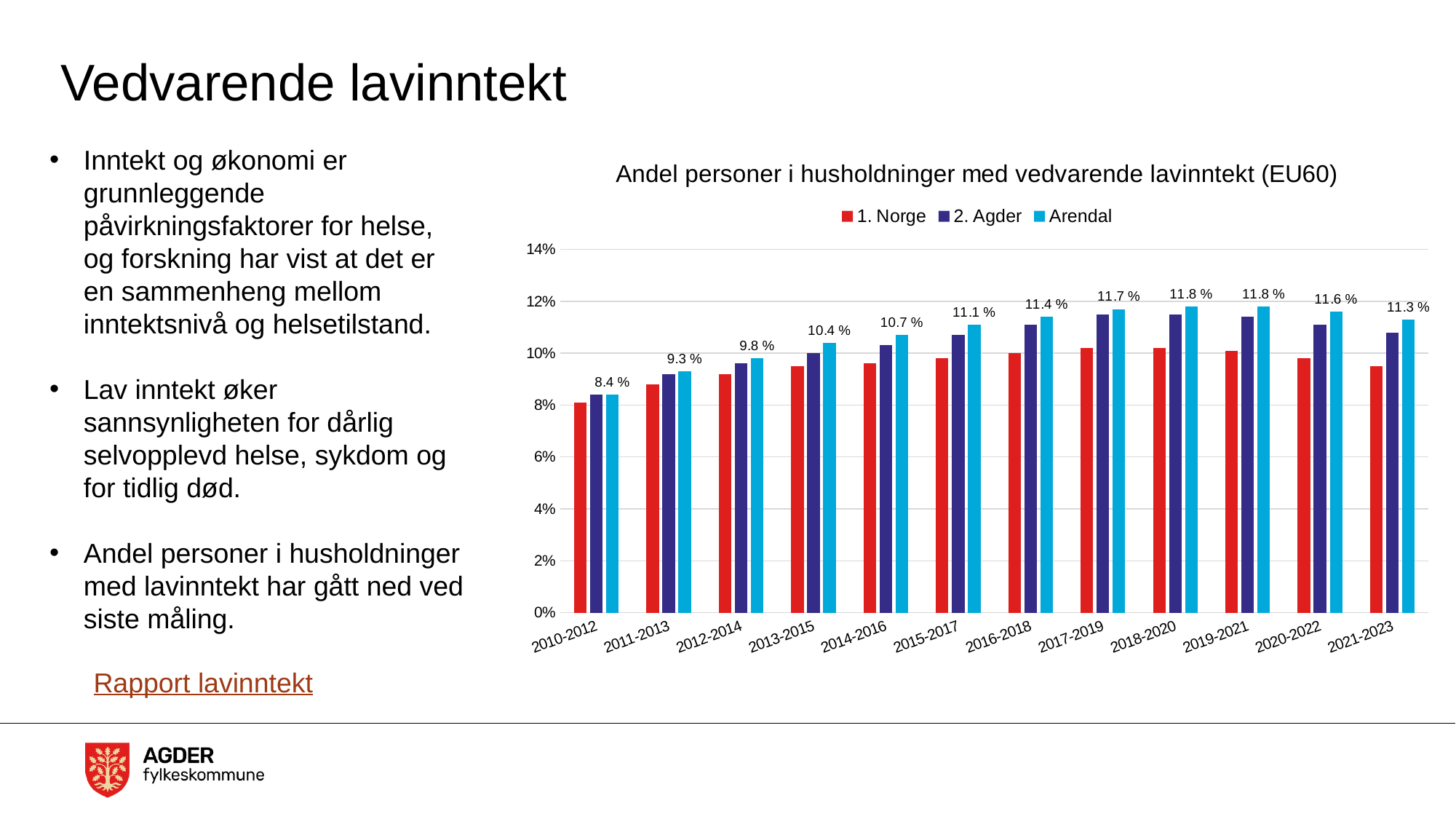
How many time periods are shown on the x axis? 12 What is the difference between the Arendal values for 2020-2022 and 2021-2023? 0.3 % Is the value for 2. Agder in 2018-2020 greater or less than 10%? greater What kind of chart is shown on the slide? Bar chart Which is larger, the Arendal value for 2013-2015 or for 2014-2016? 2014-2016 Is the value for 1. Norge in 2010-2012 greater or less than 10%? less In which period is the Arendal value lowest? 2010-2012 What is the difference between the Arendal values for 2010-2012 and 2018-2020? 3.4 % What is the value for Arendal in 2015-2017? 11.1 % How many series does the legend list? 3 What is the value for Arendal in 2010-2012? 8.4 % What is the value for Arendal in 2021-2023? 11.3 %